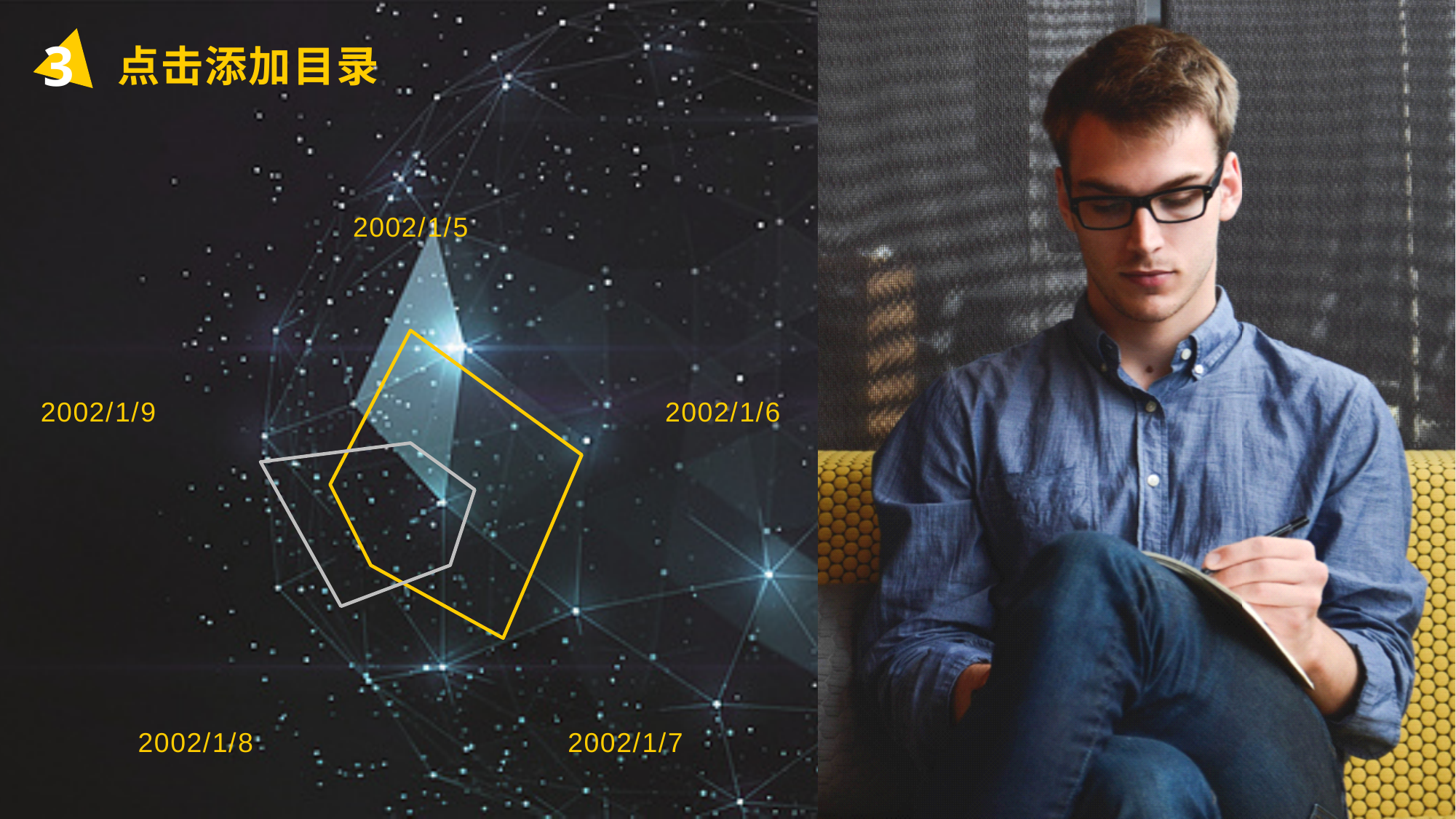
On the radar chart, which series has the larger value for 2002/1/6, the yellow series or the grey series? Yellow Which category label appears at the left of the radar chart? 2002/1/9 On the radar chart, which series has the larger value for 2002/1/8, the yellow series or the grey series? Grey On the radar chart, which series has the larger value for 2002/1/5, the yellow series or the grey series? Yellow How many categories (axes) does the radar chart have? 5 How many data series are plotted on the radar chart? 2 What kind of chart is shown on the left side of the slide? Radar chart Which category label appears at the top of the radar chart? 2002/1/5